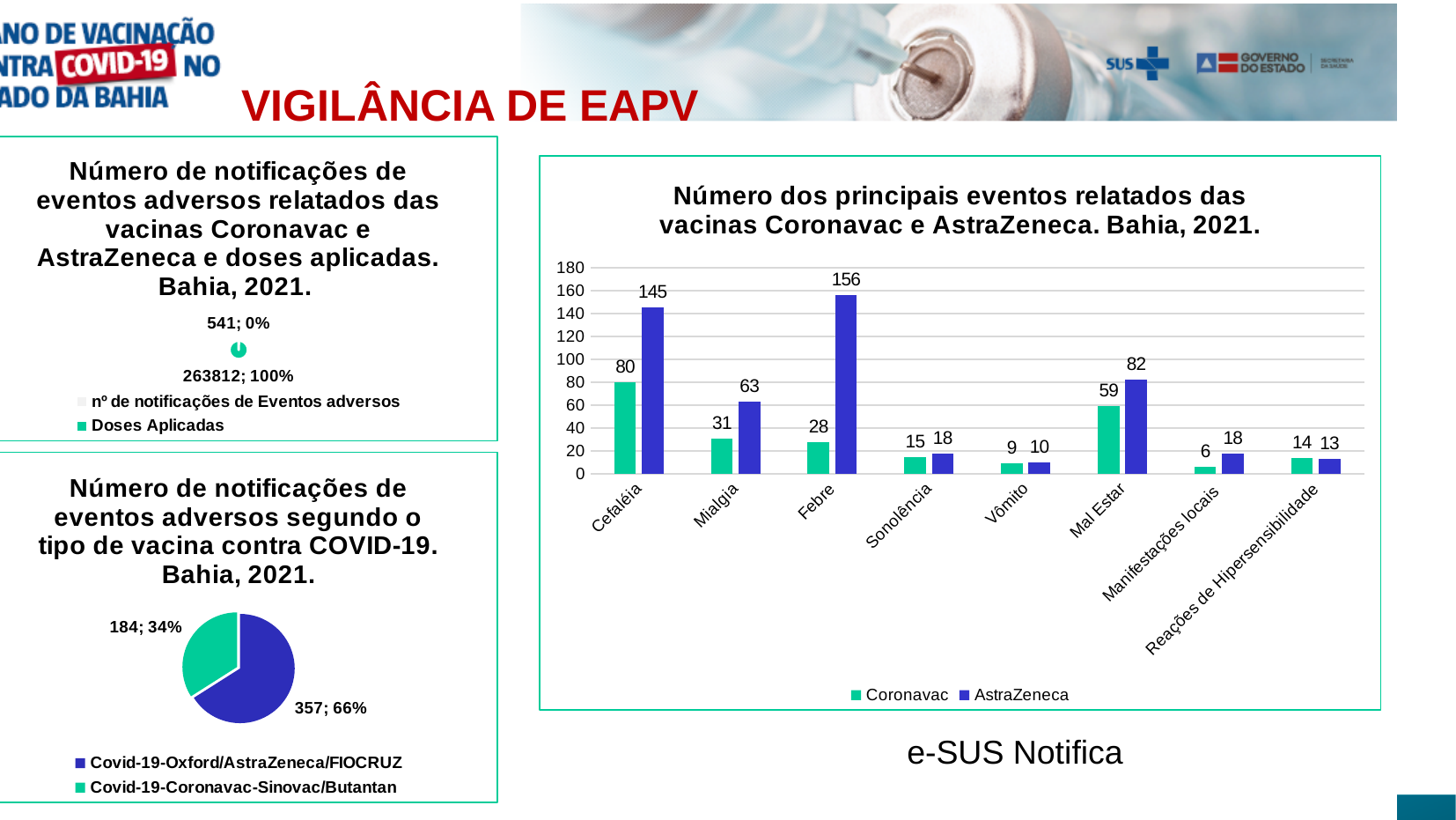
What type of chart is the chart on the right of the slide? Bar chart In the bar chart on the right, what is the Coronavac value for Cefaléia? 80 How many event categories are shown in the bar chart on the right? 8 In the pie chart at the bottom left, what is the value for Covid-19-Coronavac-Sinovac/Butantan? 184 In the bar chart on the right, which event has the highest AstraZeneca value? Febre In the bar chart on the right, which is larger for Reações de Hipersensibilidade: the Coronavac value or the AstraZeneca value? Coronavac In the pie chart 'Número de notificações de eventos adversos segundo o tipo de vacina contra COVID-19', what share does Covid-19-Oxford/AstraZeneca/FIOCRUZ have? 66% In the bar chart on the right, what is the difference between the AstraZeneca and Coronavac values for Mal Estar? 23 In the pie chart at the top left, what is the value shown for Doses Aplicadas? 263812 In the bar chart on the right, which event has the lowest Coronavac value? Manifestações locais In the bar chart 'Número dos principais eventos relatados das vacinas Coronavac e AstraZeneca', what is the AstraZeneca value for Febre? 156 How many series does the legend of the bar chart on the right list? 2